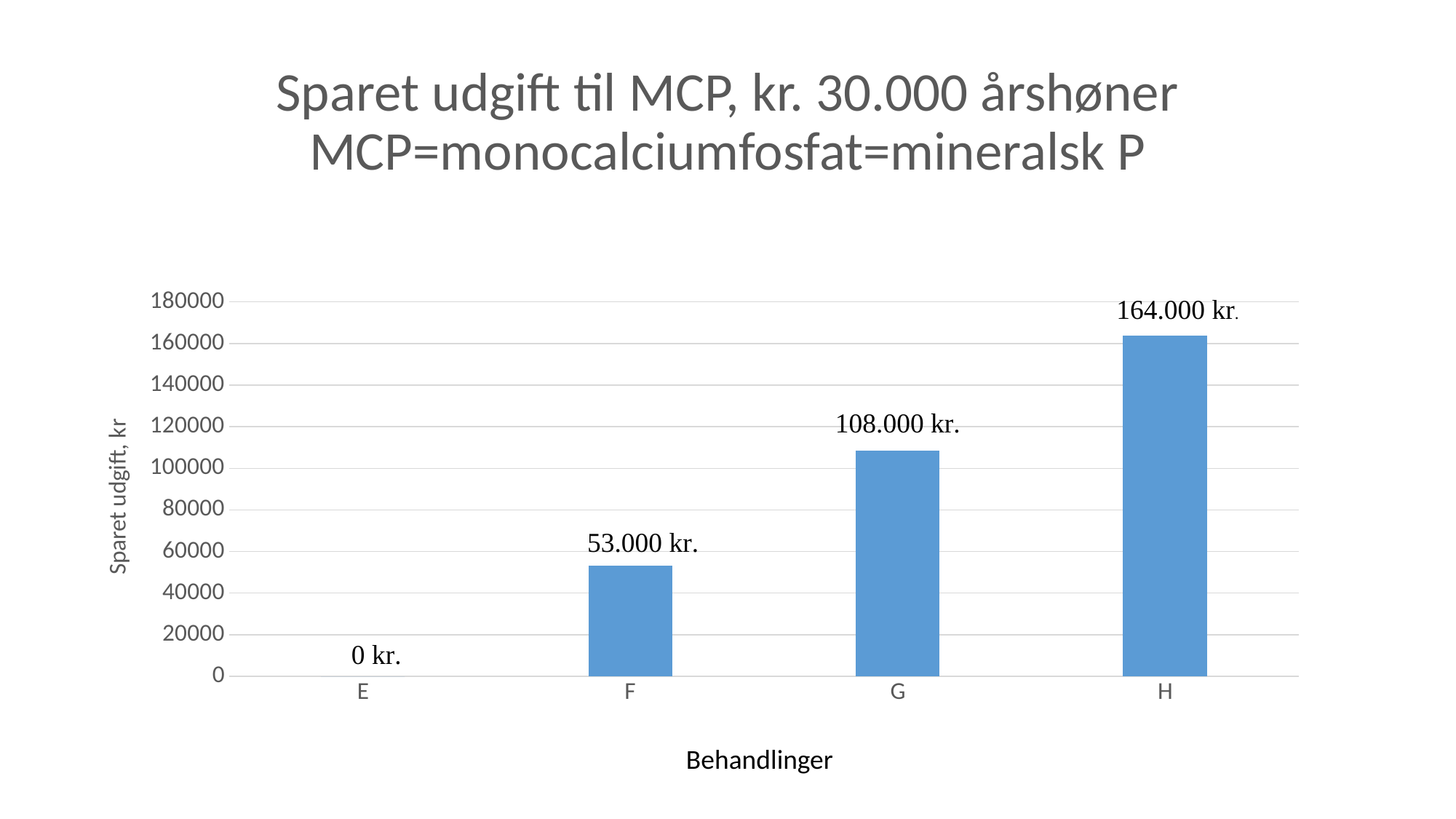
What is the value for treatment G? 108.000 kr. Which is larger, the value for F or the value for G? G Which treatment has the highest saved expense? H What is the value for treatment H? 164.000 kr. Do the values rise or fall from E to H along the x axis? rise What is the value for treatment F? 53.000 kr. Which treatment has the lowest saved expense? E What kind of chart is this? bar chart What is the difference between the values for H and G? 56.000 kr. What is the value for treatment E? 0 kr. Is the value for G greater or less than 100000? greater How many treatments are shown on the x axis? 4